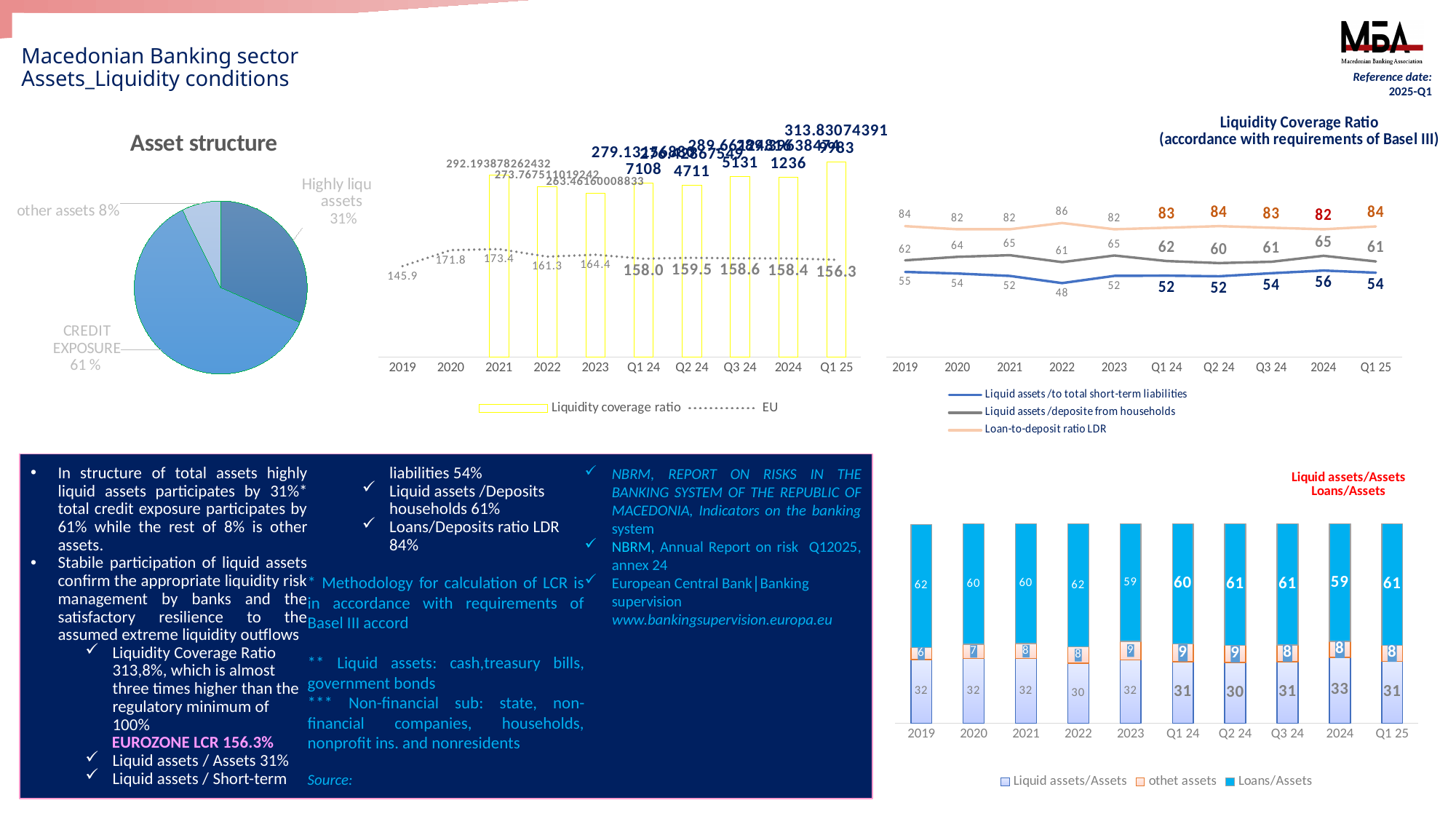
In the Asset structure pie chart, how many slices are there? 3 In the Asset structure pie chart, which slice is the largest? CREDIT EXPOSURE In the Liquidity Coverage Ratio line chart at the top right, how many series does the legend list? 3 In the Liquidity Coverage Ratio line chart at the top right, what is the Loan-to-deposit ratio LDR for Q1 25? 84 In the middle chart with the yellow bars, what is the EU value for Q1 25? 156.3 In the stacked bar chart at the bottom right, what is the Loans/Assets value for 2023? 59 In the middle chart with the yellow bars, what is the EU value for 2019? 145.9 In the Liquidity Coverage Ratio line chart at the top right, what is the difference between Liquid assets /deposite from households and Liquid assets /to total short-term liabilities in 2024? 9 In the Asset structure pie chart, what share do highly liquid assets have? 31% In the stacked bar chart at the bottom right, what is the Liquid assets/Assets value for 2024? 33 In the middle chart with the yellow bars, which series is shown as a dotted line? EU In the Liquidity Coverage Ratio line chart at the top right, what is the value of Liquid assets /to total short-term liabilities for 2022? 48